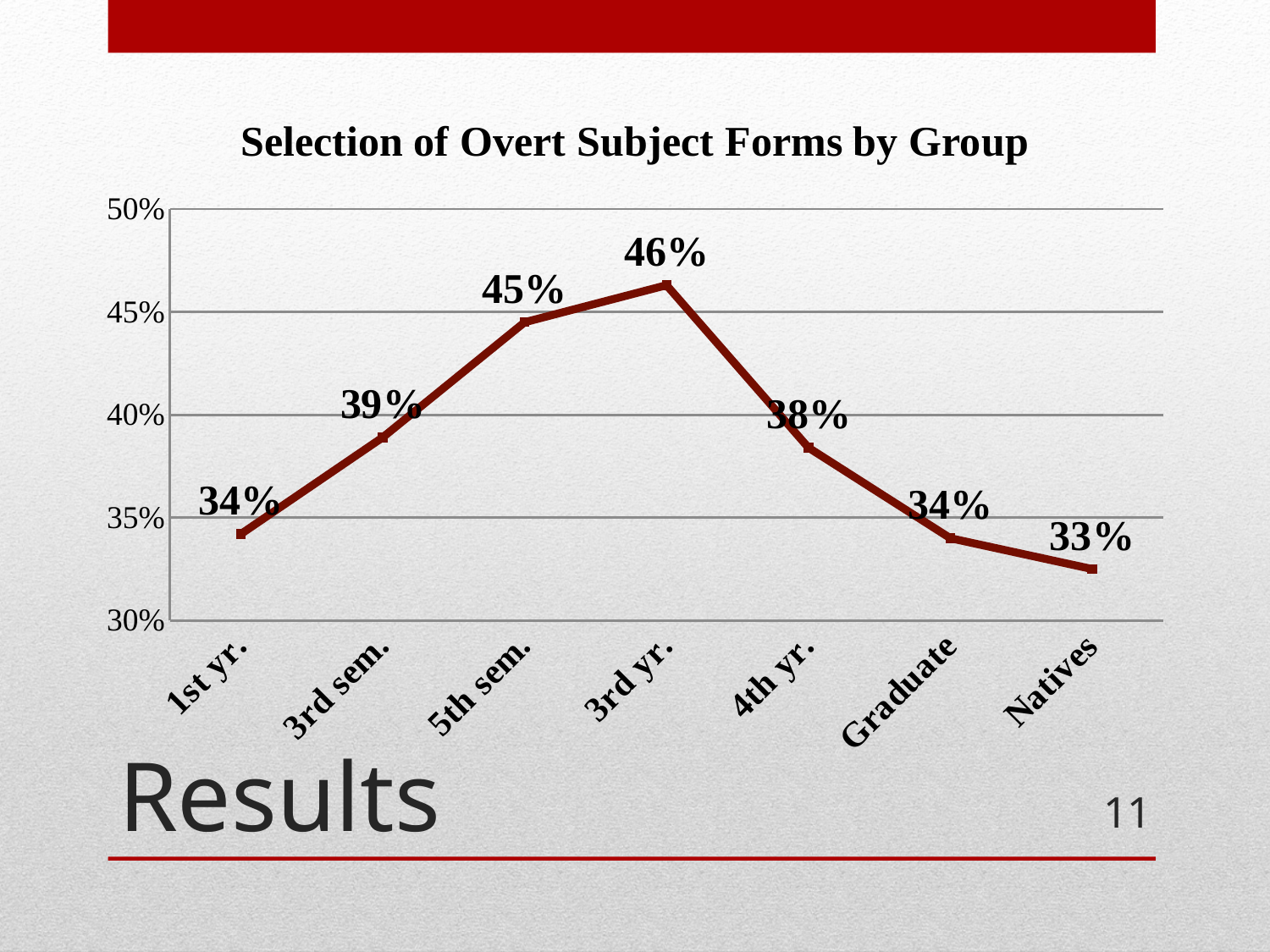
What is the value for 5th sem.? 45% Which is larger, the value for 3rd sem. or the value for 4th yr.? 3rd sem. Is the value for 4th yr. greater or less than 40%? less What is the value for 3rd yr.? 46% Which group has the lowest value? Natives Which group has the highest value? 3rd yr. What is the difference between the values for 3rd yr. and 1st yr.? 12% What kind of chart is shown? line chart What is the title of the chart? Selection of Overt Subject Forms by Group Do the values rise or fall from 3rd yr. to Natives? fall How many groups are plotted on the x axis? 7 What is the value for Natives? 33%